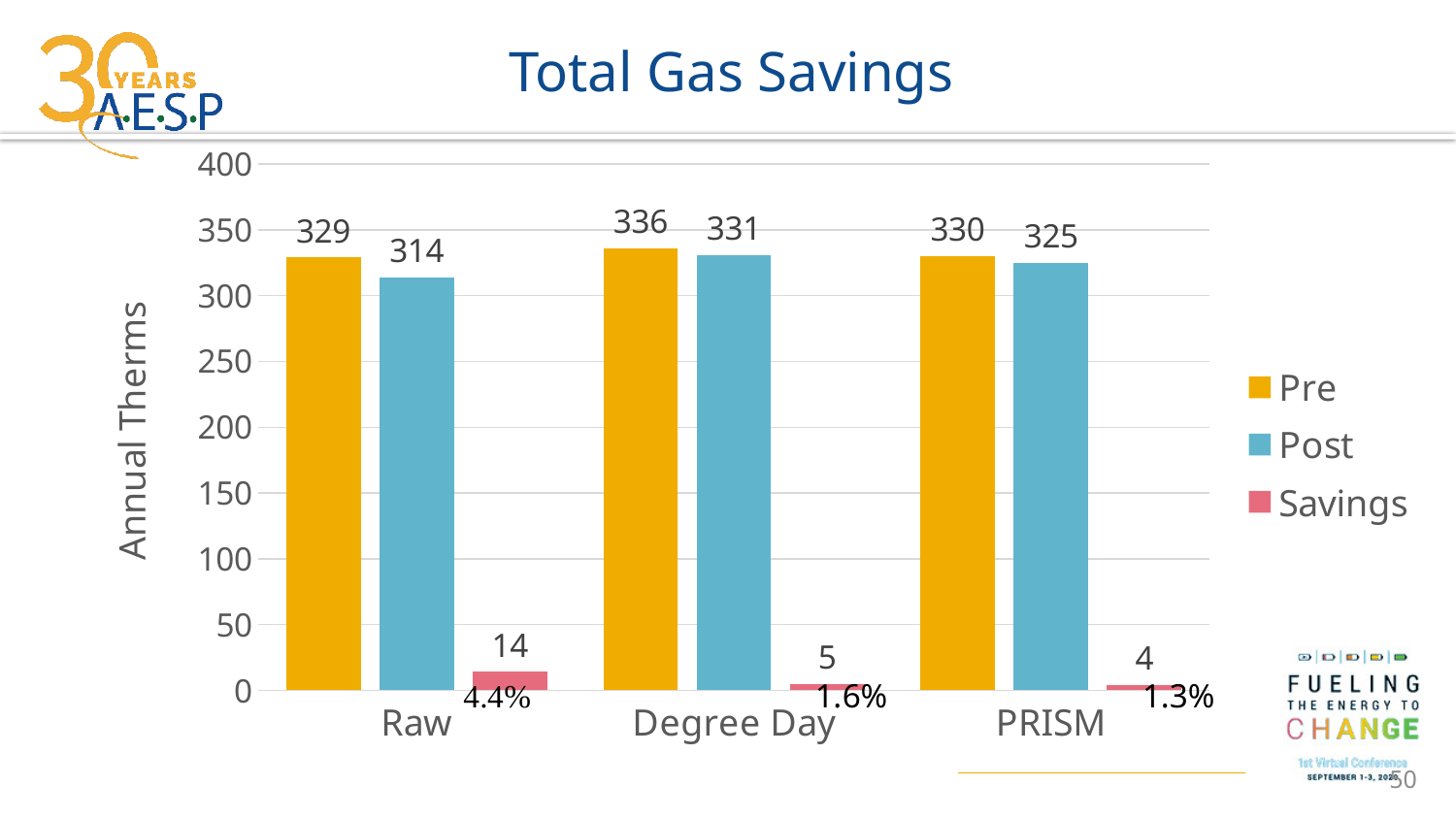
How many categories are shown on the x axis? 3 What kind of chart is shown? Bar chart Which category has the highest Pre value? Degree Day Is the Pre value for PRISM greater or less than 300? greater What is the Pre value for Raw? 329 How many series does the legend list? 3 Is the Post value for PRISM larger than the Post value for Raw? Yes What is the Savings value for PRISM? 4 What is the difference between the Pre and Post values for Raw? 15 Which category has the lowest Savings value? PRISM What is the Post value for Degree Day? 331 What is the y-axis label of the chart? Annual Therms